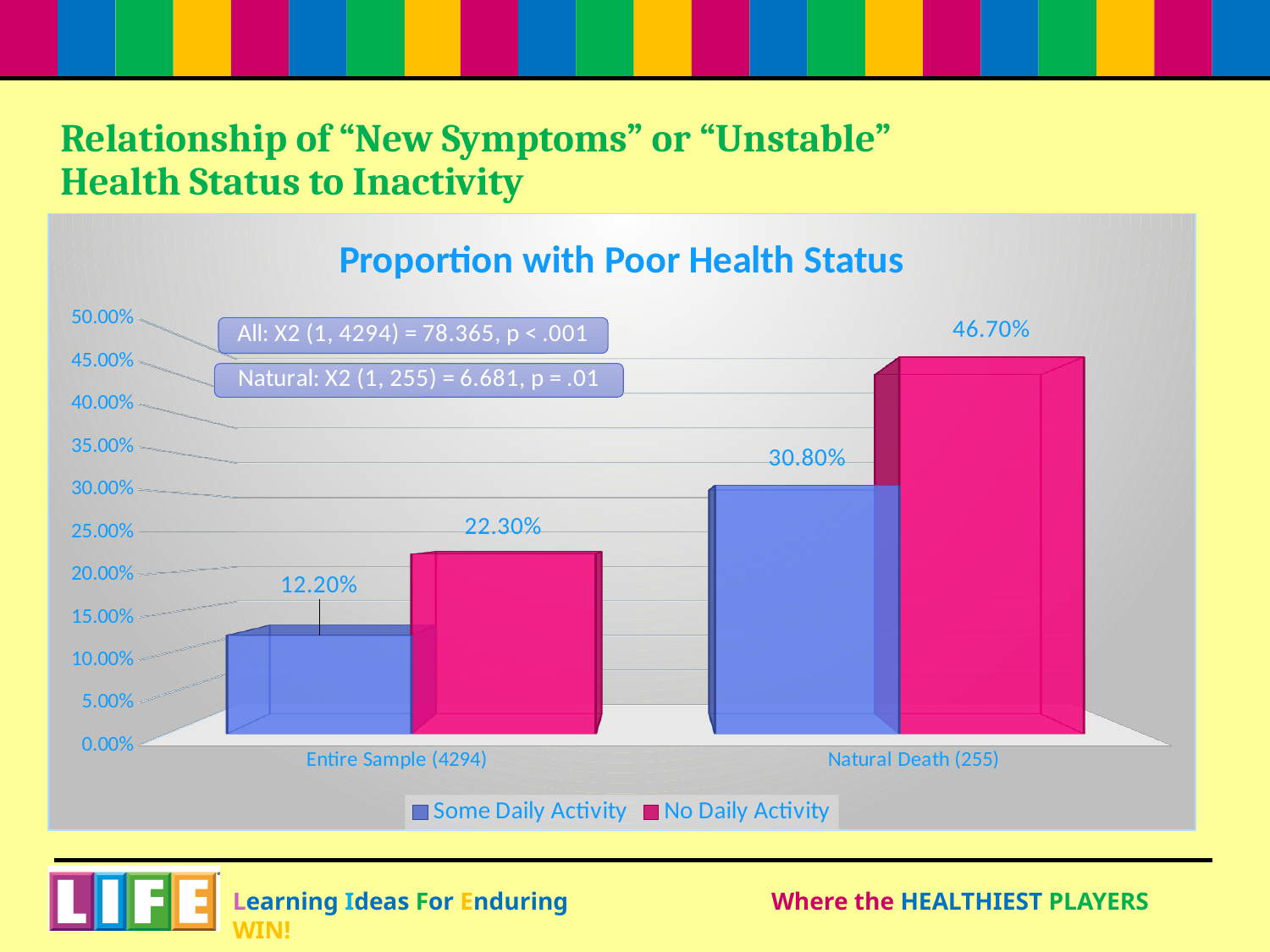
What is the title of the chart? Proportion with Poor Health Status How many categories are shown on the x axis? 2 Which category has the highest value for No Daily Activity? Natural Death (255) How many series does the legend list? 2 What is the difference between No Daily Activity and Some Daily Activity in the Entire Sample (4294) category? 10.10% Which is larger in the Entire Sample (4294) category: Some Daily Activity or No Daily Activity? No Daily Activity What is the value for Some Daily Activity in the Entire Sample (4294) category? 12.20% What is the difference between No Daily Activity and Some Daily Activity in the Natural Death (255) category? 15.90% What is the value for No Daily Activity in the Entire Sample (4294) category? 22.30% Which category has the lowest value for Some Daily Activity? Entire Sample (4294) What is the value for Some Daily Activity in the Natural Death (255) category? 30.80% What is the value for No Daily Activity in the Natural Death (255) category? 46.70%